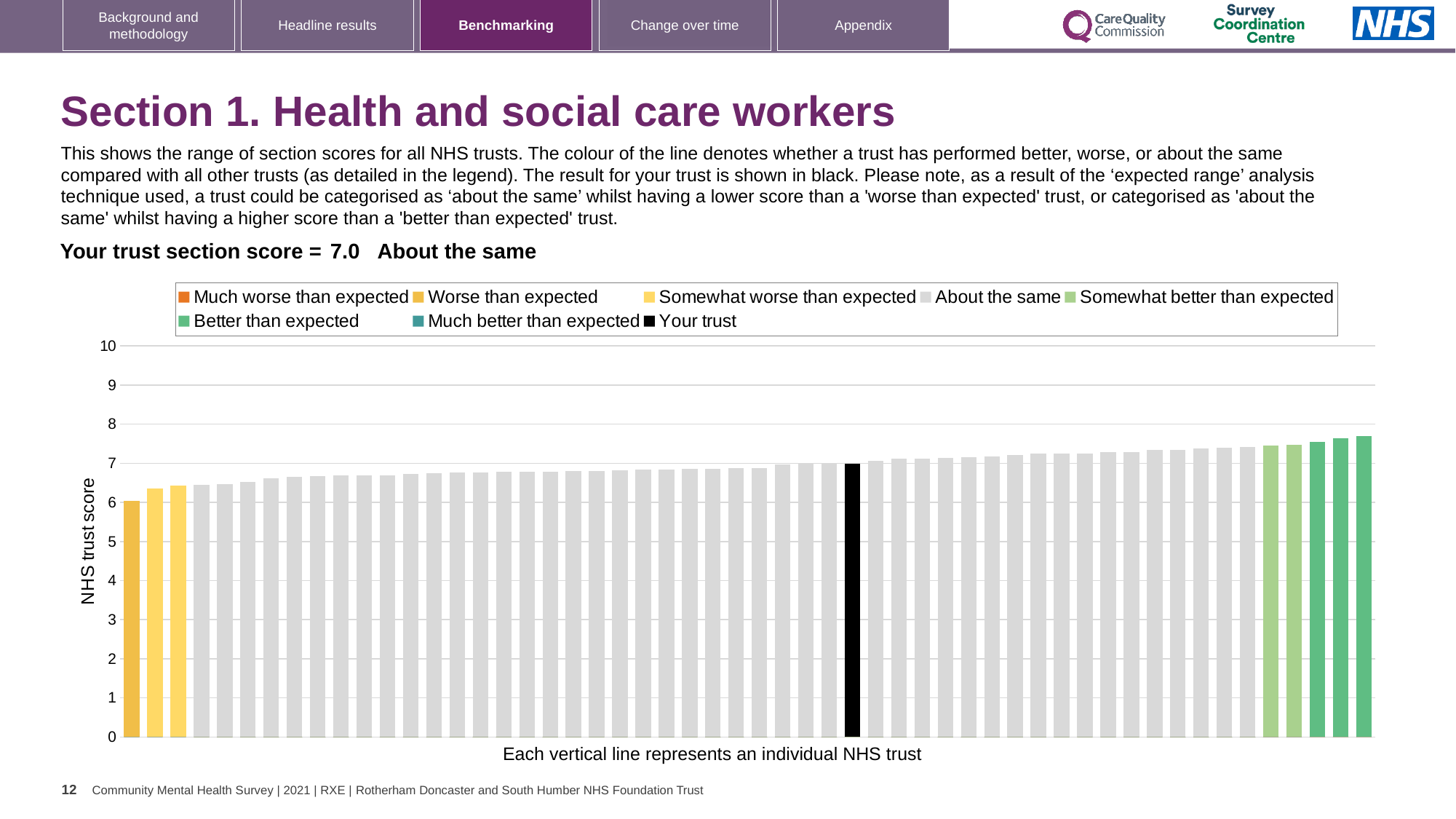
Which is larger: the score for your trust or the score of the leftmost bar? Your trust What colour is the bar representing your trust? Black Is the value of the highest bar in the chart greater or less than 7? greater Do the bar values rise or fall from left to right along the x axis? Rise Which performance category is your trust placed in? About the same What kind of chart is shown on the slide? Bar chart What is the label on the vertical axis of the chart? NHS trust score Is the value of the highest bar in the chart greater or less than 8? less How many entries does the chart legend list? 8 Is the value of the lowest bar in the chart greater or less than 7? less What is the section score for your trust? 7.0 How many bars are coloured as 'Somewhat worse than expected'? 2